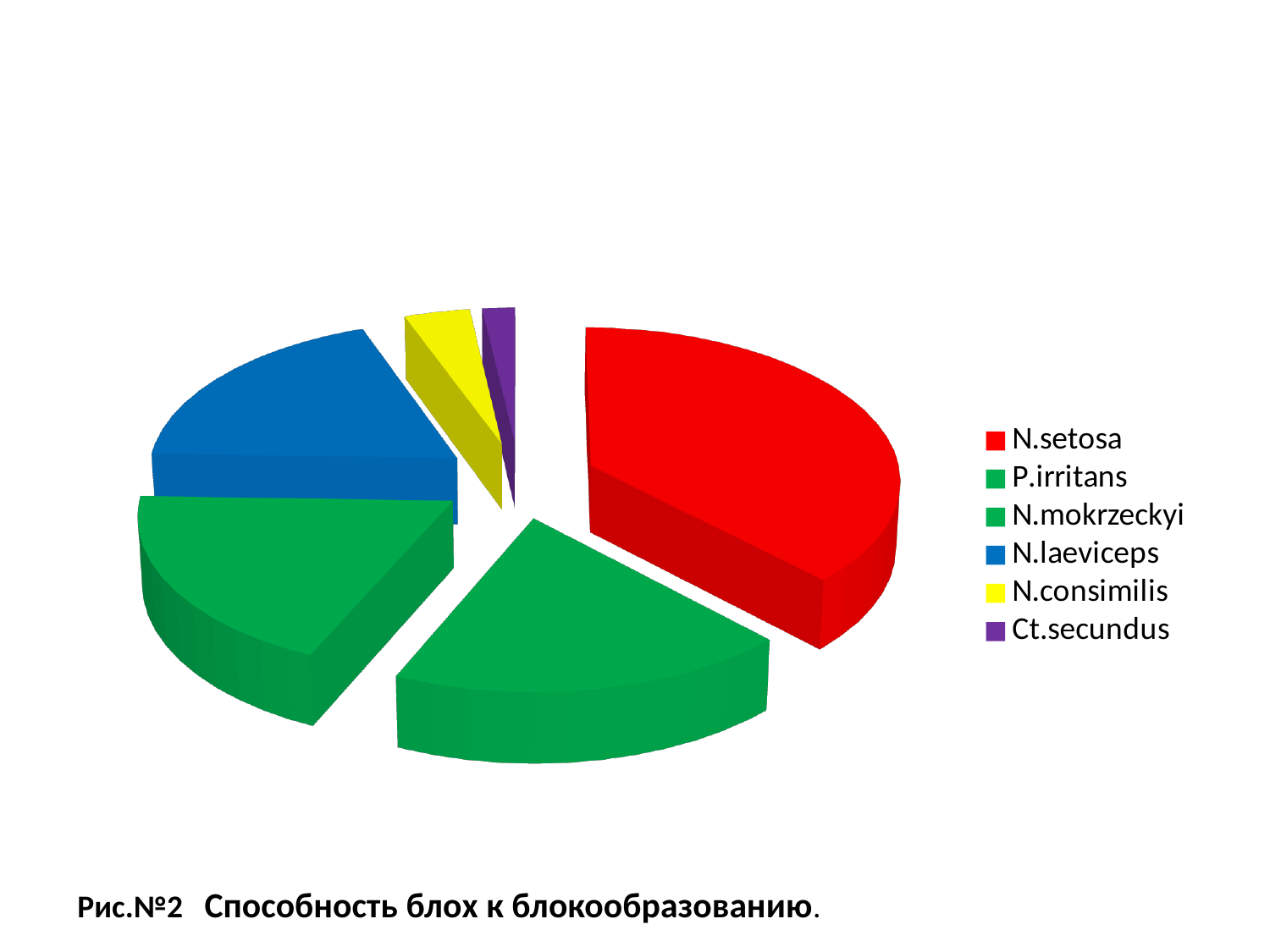
Which slice is larger, N.setosa or N.consimilis? N.setosa How many entries does the legend list? 6 What kind of chart is shown on the slide? pie chart Which category has the smallest slice of the pie? Ct.secundus Which slice is larger, N.laeviceps or Ct.secundus? N.laeviceps Which slice is larger, N.consimilis or Ct.secundus? N.consimilis Which category has the largest slice of the pie? N.setosa What colour is the N.setosa slice? red What is the caption below the chart? Рис.№2 Способность блох к блокообразованию. How many slices does the pie chart have? 6